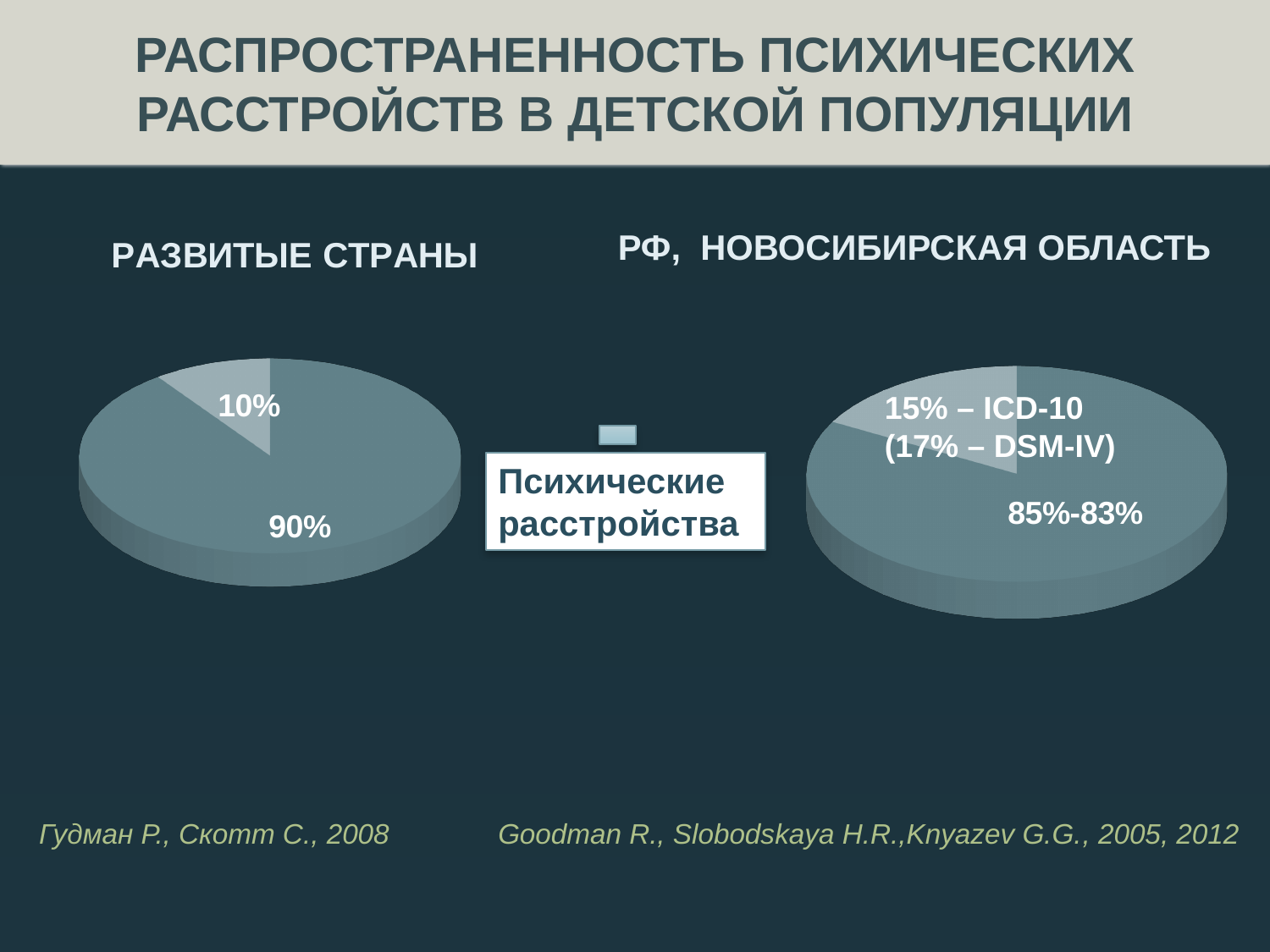
In the РФ, НОВОСИБИРСКАЯ ОБЛАСТЬ pie chart, what label is on the large slice? 85%-83% What does the legend entry between the two pie charts say? Психические расстройства Which is larger: the small slice of the РАЗВИТЫЕ СТРАНЫ pie (10%) or the ICD-10 slice of the РФ, НОВОСИБИРСКАЯ ОБЛАСТЬ pie (15%)? ICD-10 slice (15%) How many slices does the РФ, НОВОСИБИРСКАЯ ОБЛАСТЬ pie chart have? 2 In the РАЗВИТЫЕ СТРАНЫ pie chart, what share is labelled on the small slice? 10% In the РАЗВИТЫЕ СТРАНЫ pie chart, what share is labelled on the large slice? 90% In the РАЗВИТЫЕ СТРАНЫ pie chart, what is the difference between the two slices' shares? 80% In the РФ, НОВОСИБИРСКАЯ ОБЛАСТЬ pie chart, what share is given for DSM-IV? 17% What kind of chart is shown under the heading РАЗВИТЫЕ СТРАНЫ? Pie chart In the РФ, НОВОСИБИРСКАЯ ОБЛАСТЬ pie chart, what share is given for ICD-10? 15% In the РАЗВИТЫЕ СТРАНЫ pie chart, which slice is larger, the 10% slice or the 90% slice? 90% How many slices does the РАЗВИТЫЕ СТРАНЫ pie chart have? 2